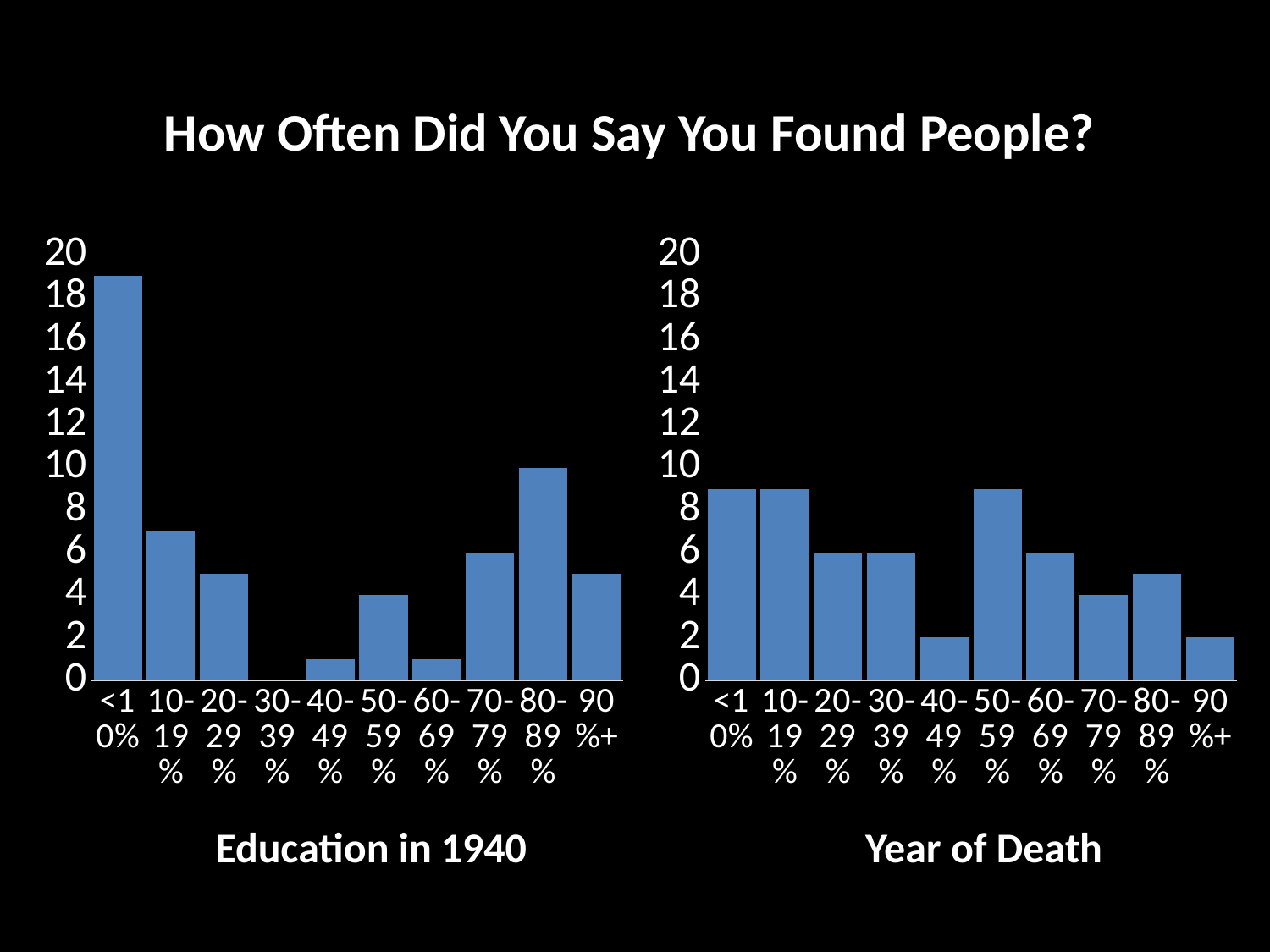
In the 'Education in 1940' chart, what is the value for 80-89%? 10 In the 'Education in 1940' chart, is the value for 10-19% greater or less than 6? greater In the 'Education in 1940' chart, is the value for <10% greater or less than 18? greater In the 'Education in 1940' chart, which category has the lowest value? 30-39% In the 'Year of Death' chart, what is the value for 40-49%? 2 In the 'Year of Death' chart, is the value for <10% greater or less than 8? greater In the 'Year of Death' chart, which is larger, the value for 50-59% or the value for 70-79%? 50-59% How many categories are shown on the x axis of the 'Year of Death' chart? 10 What kind of chart is the 'Education in 1940' chart? bar chart What is the title of the slide above the two charts? How Often Did You Say You Found People? In the 'Education in 1940' chart, which is larger, the value for 80-89% or the value for 90%+? 80-89% In the 'Education in 1940' chart, which category has the highest bar? <10%